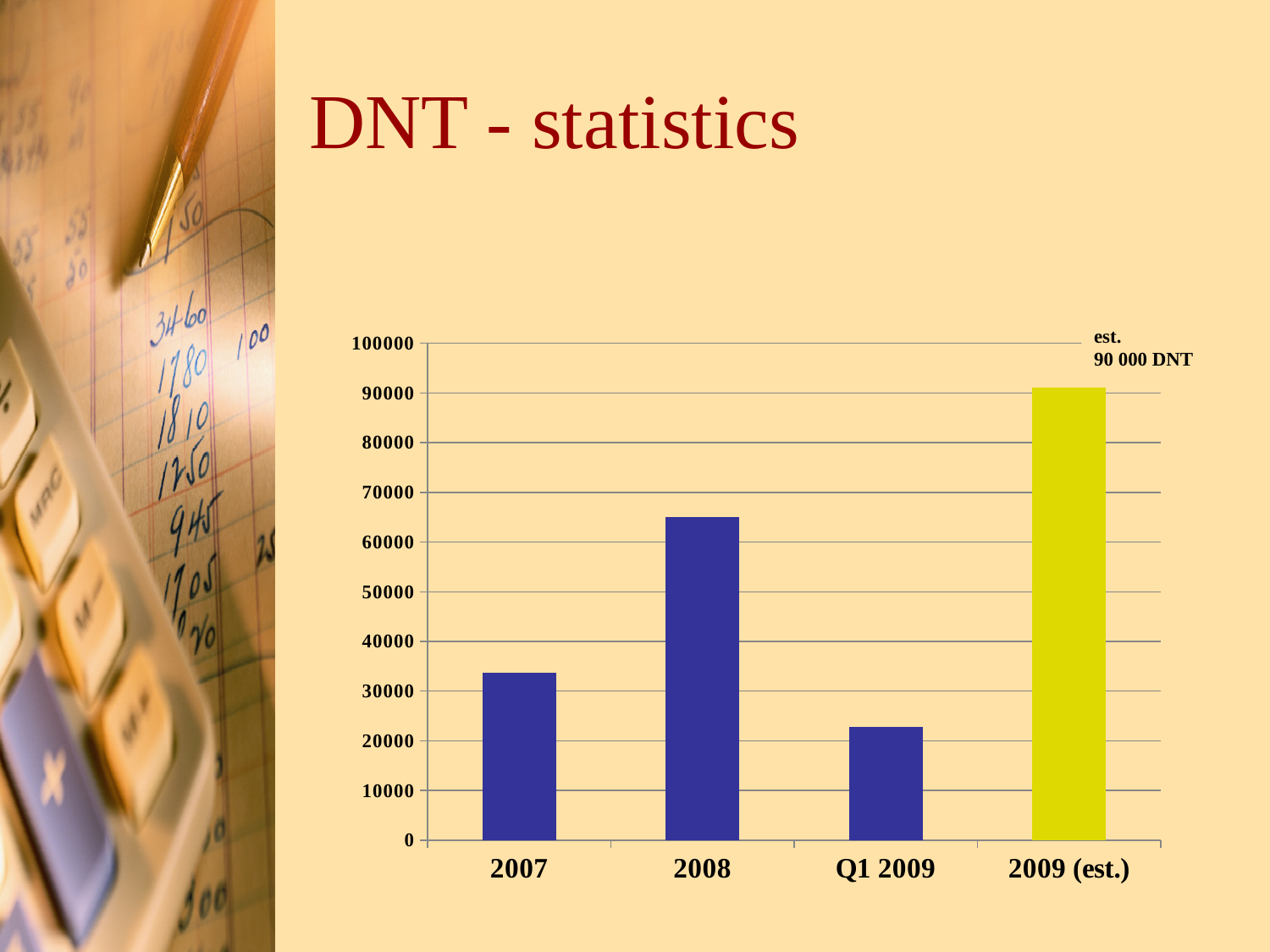
How many categories are shown on the x axis of the chart? 4 What kind of chart is shown on the slide? bar chart Is the value for 2008 greater or less than 60000? greater Is the value for 2009 (est.) greater or less than 80000? greater Which is larger, the value for 2007 or the value for Q1 2009? 2007 Which is larger, the value for 2007 or the value for 2008? 2008 Is the value for Q1 2009 greater or less than 30000? less Which category has the highest bar in the chart? 2009 (est.) What estimated amount is annotated next to the 2009 (est.) bar? 90 000 DNT Which category has the lowest bar in the chart? Q1 2009 What is the title of the slide containing the chart? DNT - statistics